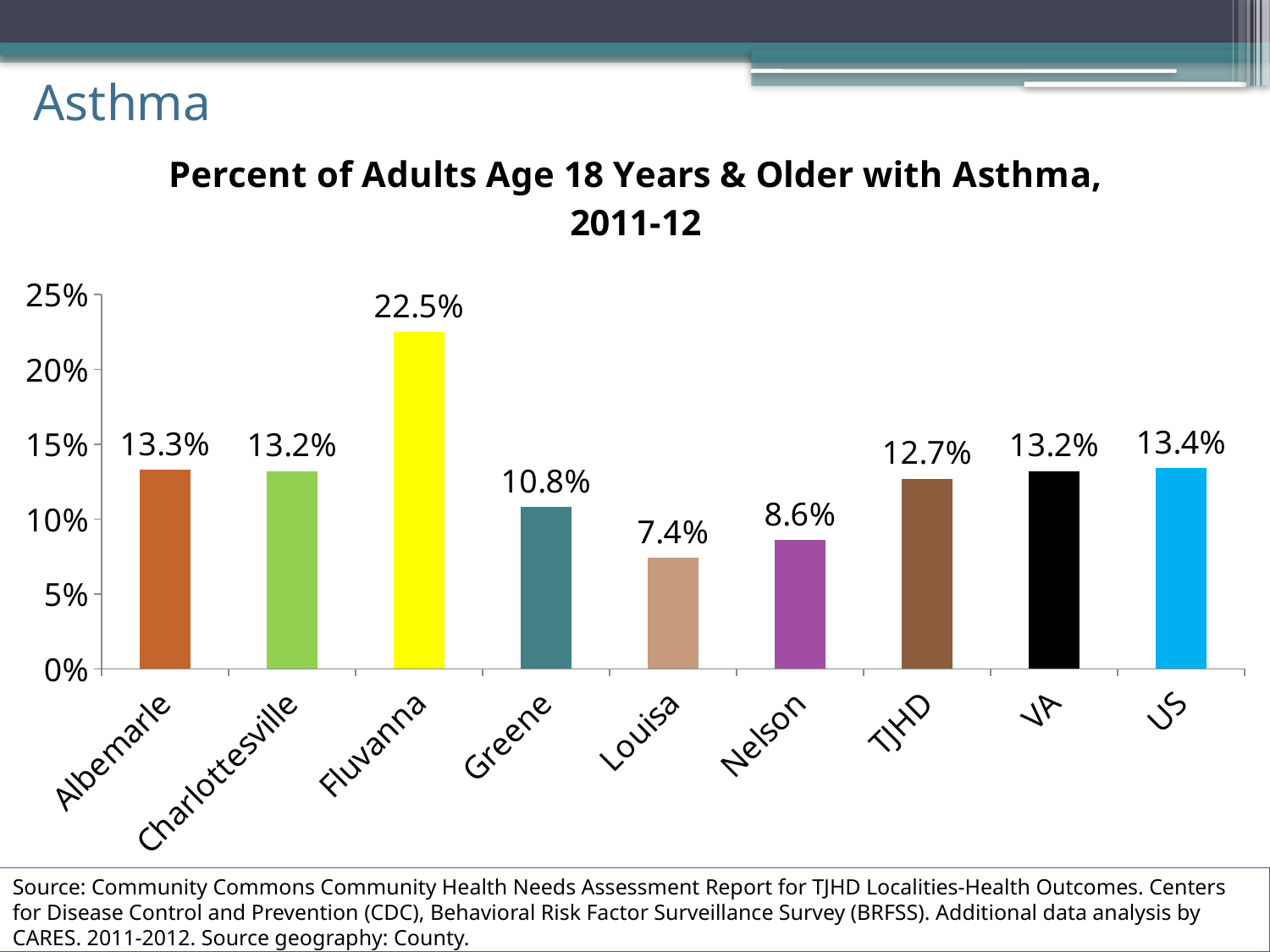
What is the percent of adults with asthma in Fluvanna? 22.5% Which locality has the highest percent of adults with asthma? Fluvanna What kind of chart is shown on the slide? bar chart What is the percent of adults with asthma in Louisa? 7.4% What is the value shown for TJHD? 12.7% What is the difference between the Fluvanna value and the US value? 9.1% What is the difference between the Greene and Nelson values? 2.2% Which category has the lowest percent of adults with asthma? Louisa Which is larger, the value for Albemarle or the value for TJHD? Albemarle Is the value for Nelson greater or less than 10%? less How many categories are shown on the x axis? 9 What is the title of the chart? Percent of Adults Age 18 Years & Older with Asthma, 2011-12